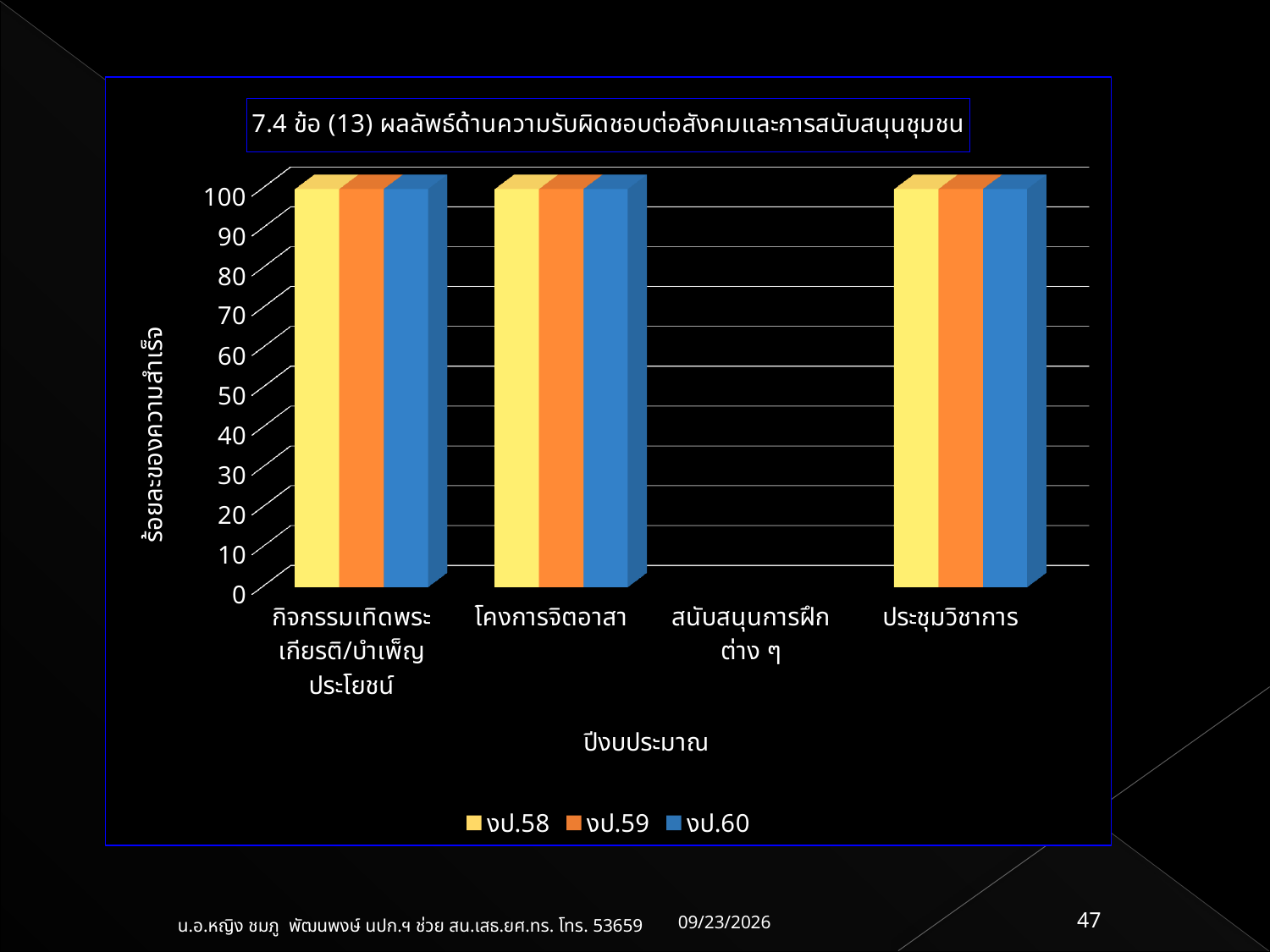
Is the value for ประชุมวิชาการ in the งป.60 series greater or less than 50? greater Which category shows no visible bars for any series? สนับสนุนการฝึกต่าง ๆ Which category has the lowest values across all series? สนับสนุนการฝึกต่าง ๆ Is the value for กิจกรรมเทิดพระเกียรติ/บำเพ็ญประโยชน์ in the งป.58 series greater or less than 90? greater What is the value for โครงการจิตอาสา in the งป.58 series? 100 How many categories are shown on the x axis? 4 What is the value for ประชุมวิชาการ in the งป.59 series? 100 What kind of chart is shown on the slide? bar chart What is the label on the vertical axis? ร้อยละของความสำเร็จ What are the series names listed in the legend? งป.58, งป.59, งป.60 In the งป.59 series, which is larger: โครงการจิตอาสา or สนับสนุนการฝึกต่าง ๆ? โครงการจิตอาสา How many series does the legend list? 3